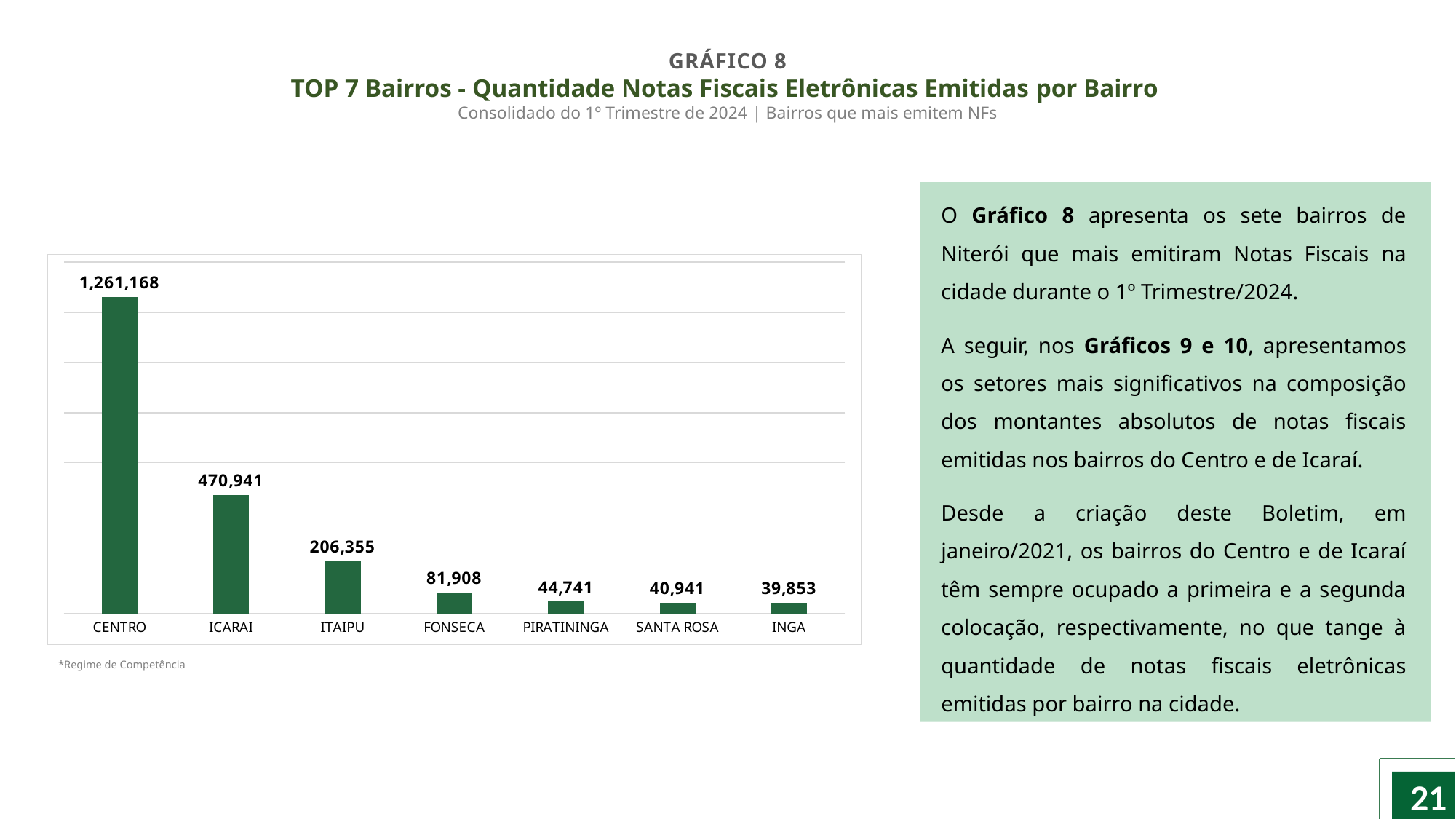
What is the value for CENTRO? 1,261,168 What is the difference between the values for ITAIPU and FONSECA? 124,447 Which bairro has the highest value? CENTRO What kind of chart is shown? Bar chart What is the value for FONSECA? 81,908 What is the difference between the values for CENTRO and ICARAI? 790,227 How many bairros are shown in the chart? 7 Which bairro has the lowest value? INGA What is the value for ICARAI? 470,941 Which is larger, the value for PIRATININGA or the value for SANTA ROSA? PIRATININGA Do the values rise or fall from left to right along the x axis? Fall What is the value for INGA? 39,853